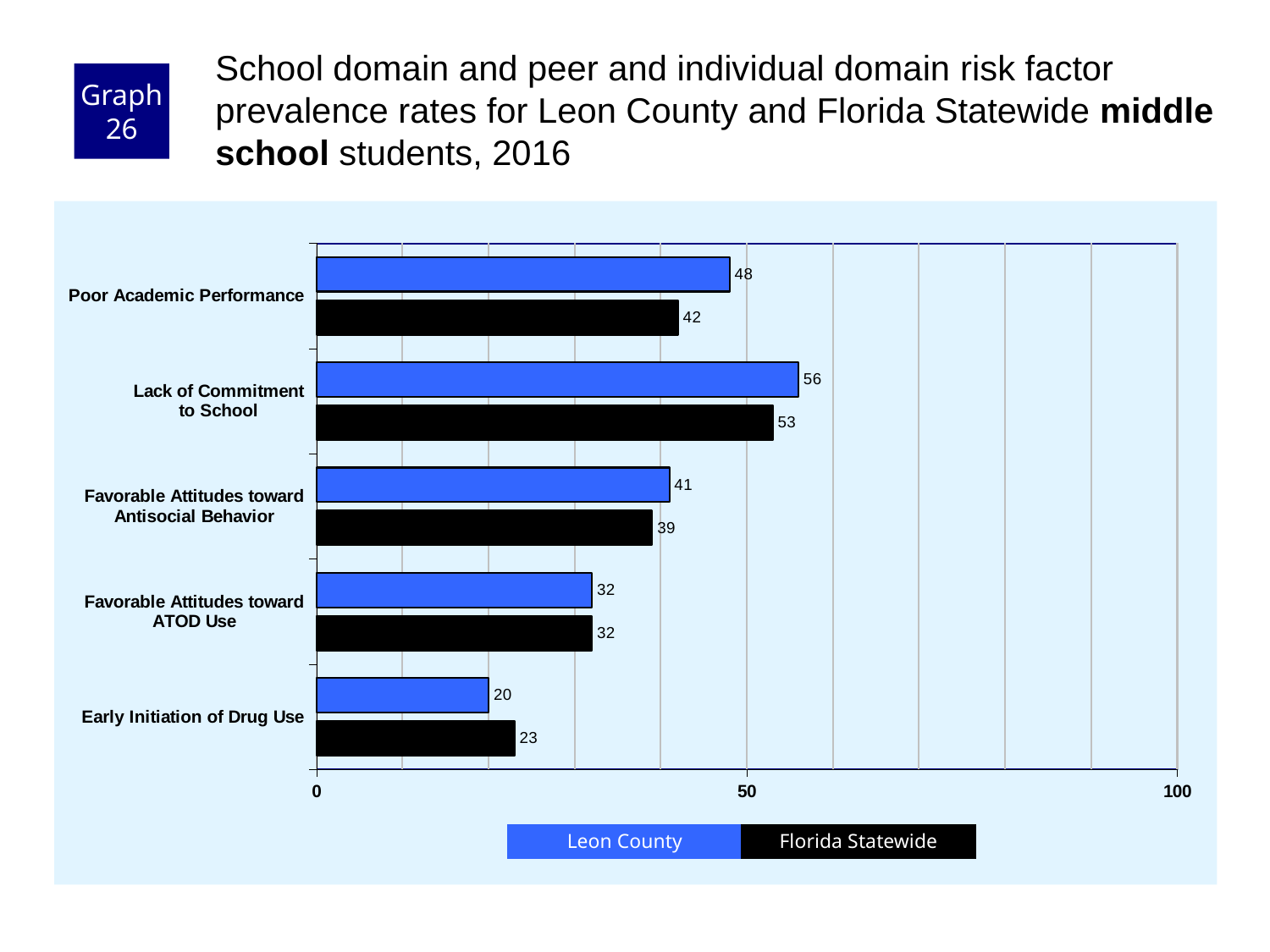
How many series does the legend list? 2 What is the Florida Statewide value for Lack of Commitment to School? 53 What is the difference between the Leon County and Florida Statewide values for Poor Academic Performance? 6 Which risk factor has the highest Leon County value? Lack of Commitment to School What kind of chart is shown on the slide? Bar chart How many risk factor categories are shown on the chart? 5 Is the Leon County value for Lack of Commitment to School greater or less than 50? greater Which risk factor has the lowest Florida Statewide value? Early Initiation of Drug Use Which colour represents Florida Statewide in the legend? Black For Early Initiation of Drug Use, which is larger: the Leon County value or the Florida Statewide value? Florida Statewide What is the Leon County value for Early Initiation of Drug Use? 20 What is the Leon County value for Poor Academic Performance? 48